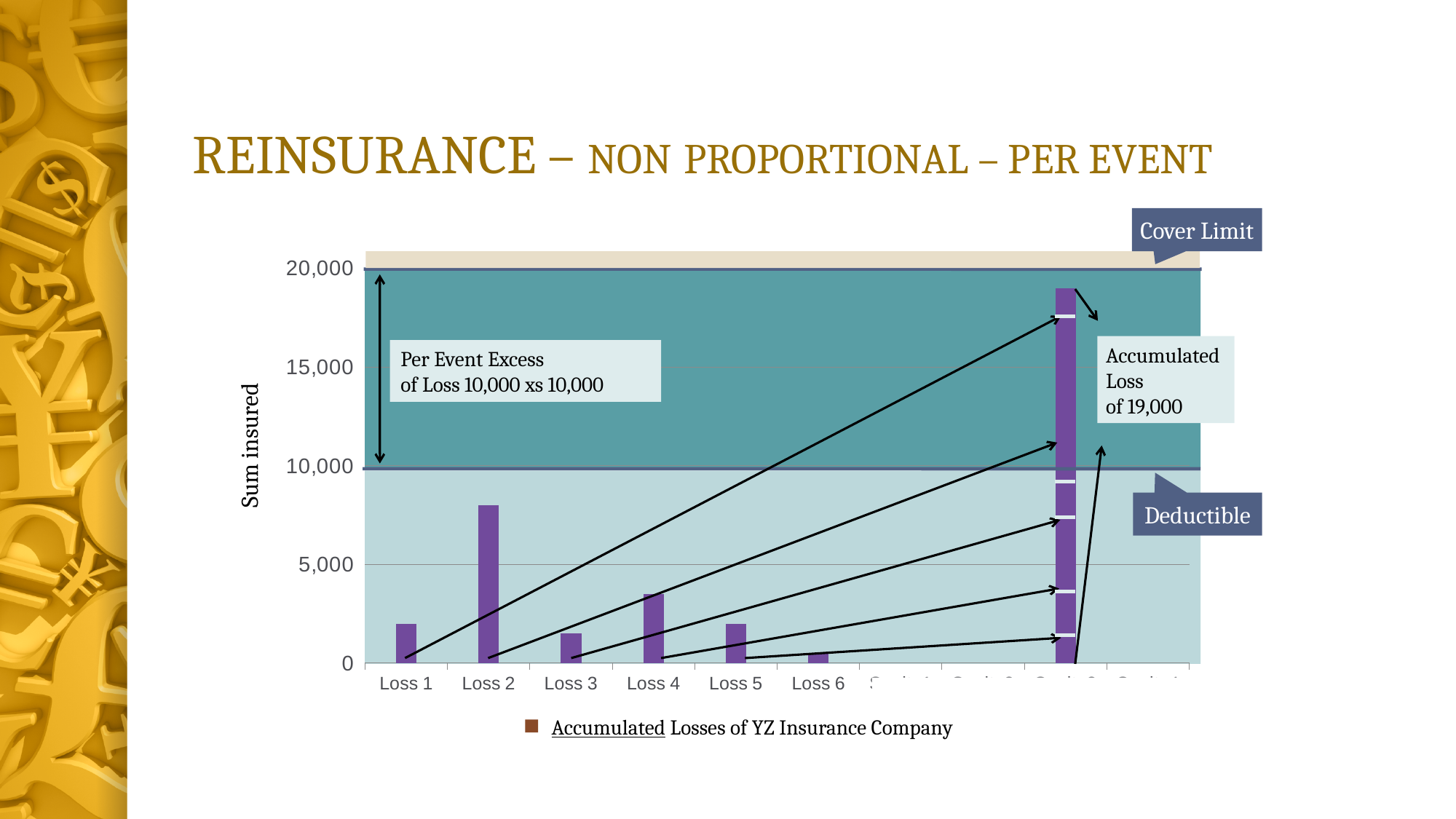
Is the value for Loss 2 greater or less than 5,000? greater What kind of chart is shown on the slide? bar chart How many series does the legend list? 1 Among Loss 1 to Loss 6, which loss has the lowest value? Loss 6 What is the title of the y axis? Sum insured Which is larger, the value for Loss 4 or the value for Loss 3? Loss 4 Is the value for Loss 4 greater or less than 5,000? less How many individual losses (Loss 1, Loss 2, ...) are labelled on the x axis? 6 What is the accumulated loss value stated on the chart? 19,000 Which is larger, the value for Loss 2 or the value for Loss 4? Loss 2 Is the accumulated loss bar greater or less than 15,000? greater Among Loss 1 to Loss 6, which loss has the highest value? Loss 2